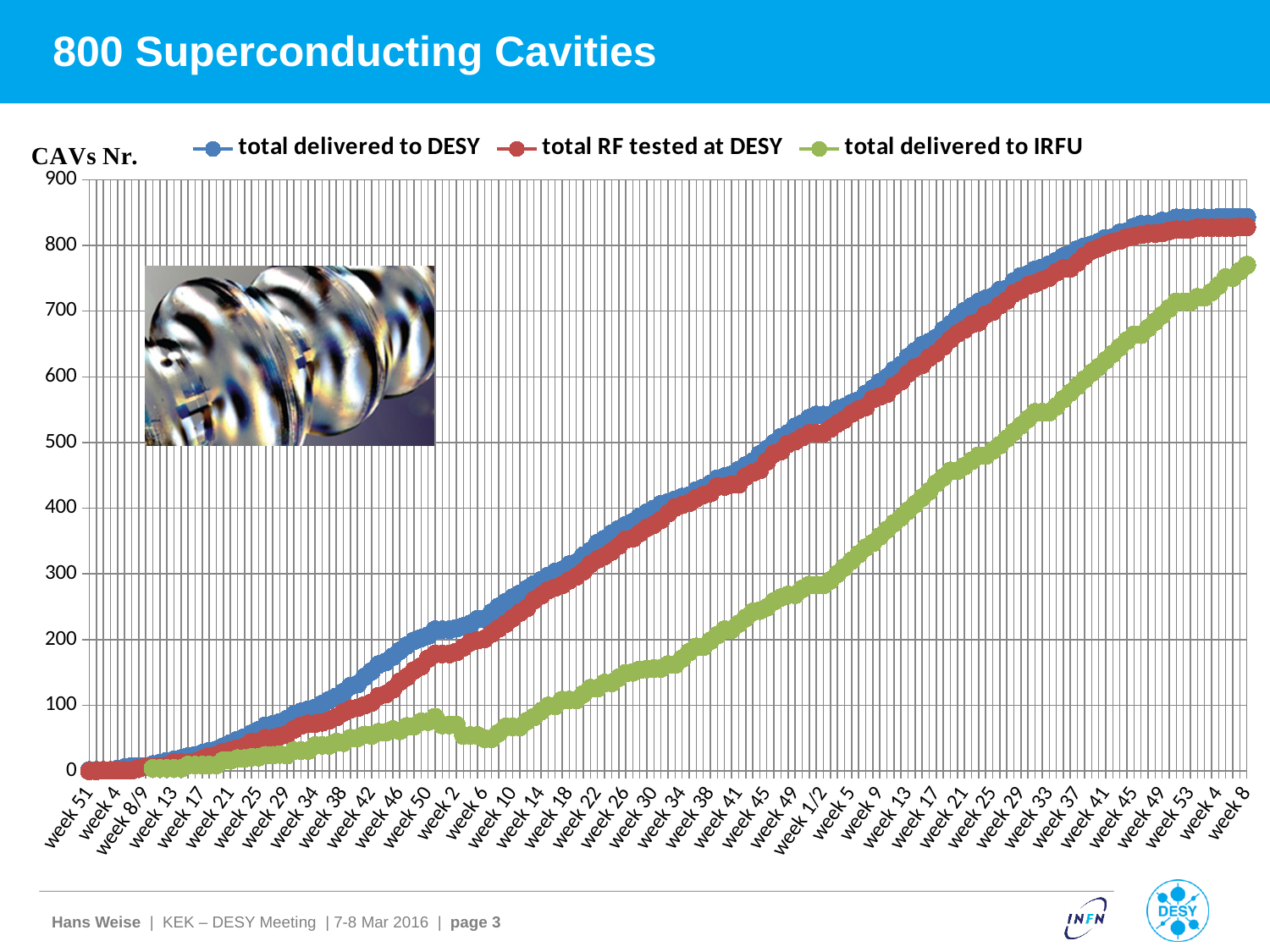
How many series does the legend list? 3 What is the highest value shown on the vertical axis? 900 Do the values for 'total delivered to DESY' rise or fall along the x axis? rise Is the final value for 'total delivered to DESY' (at week 8) greater or less than 800? greater What kind of chart is shown on the slide? line chart At the last point on the x axis, which is larger: 'total delivered to DESY' or 'total delivered to IRFU'? total delivered to DESY Which series is plotted in green? total delivered to IRFU At the last point on the x axis, which series has the lowest value? total delivered to IRFU What is the label on the vertical axis? CAVs Nr. Is the final value for 'total RF tested at DESY' (at week 8) greater or less than 800? greater Is the final value for 'total delivered to IRFU' (at week 8) greater or less than 800? less